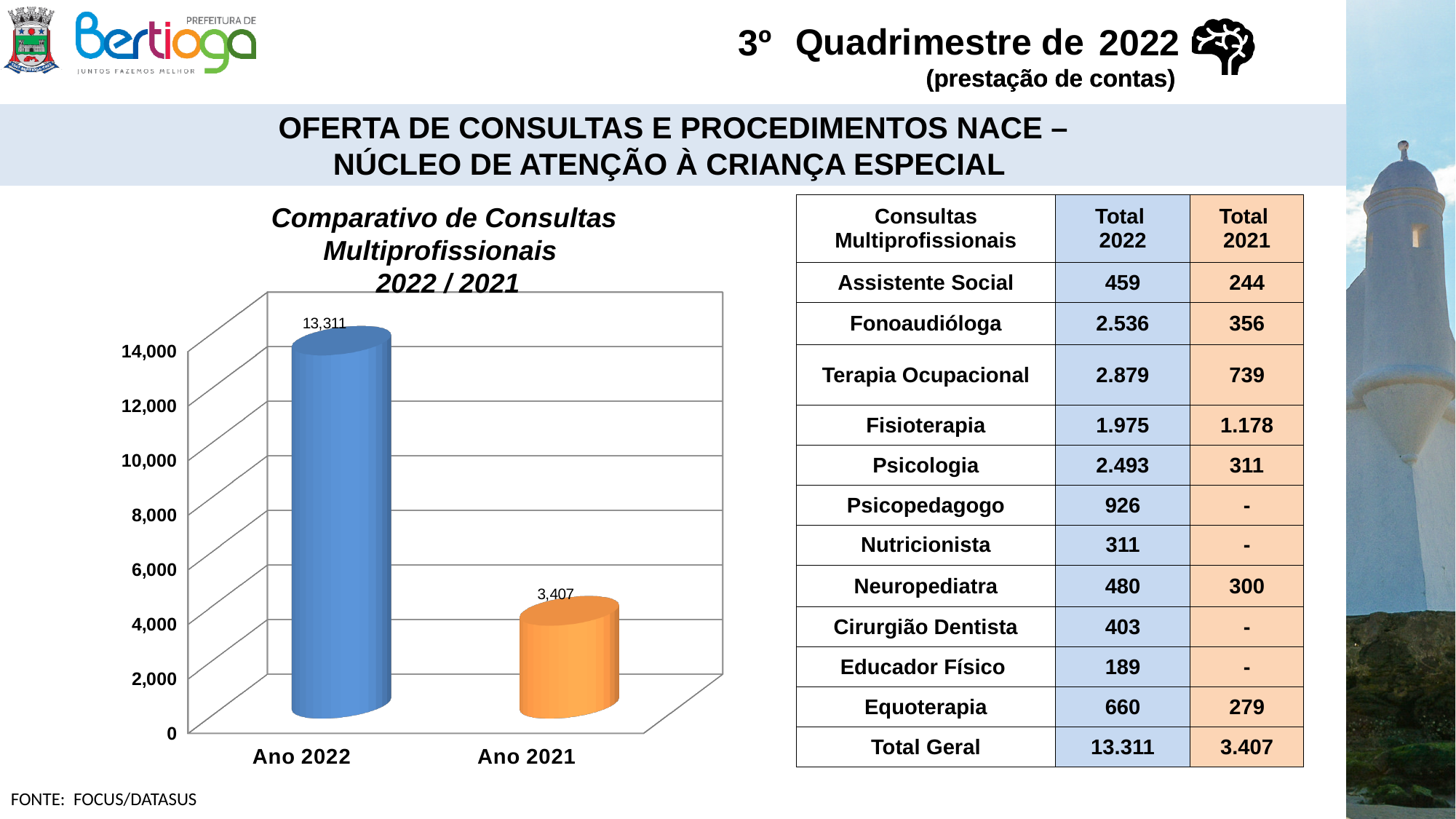
Which category has the highest value in the chart? Ano 2022 What is the difference between the values for Ano 2022 and Ano 2021? 9,904 Do the values rise or fall from Ano 2022 to Ano 2021 along the x axis? fall What is the value for Ano 2021 in the chart? 3,407 Which is larger, the value for Ano 2022 or the value for Ano 2021? Ano 2022 Which category has the lowest value in the chart? Ano 2021 What kind of chart is shown on the slide? bar chart Is the value for Ano 2021 greater or less than 4,000? less How many categories are shown on the x axis of the chart? 2 Is the value for Ano 2022 greater or less than 12,000? greater What is the title of the chart? Comparativo de Consultas Multiprofissionais 2022 / 2021 What is the value for Ano 2022 in the chart? 13,311